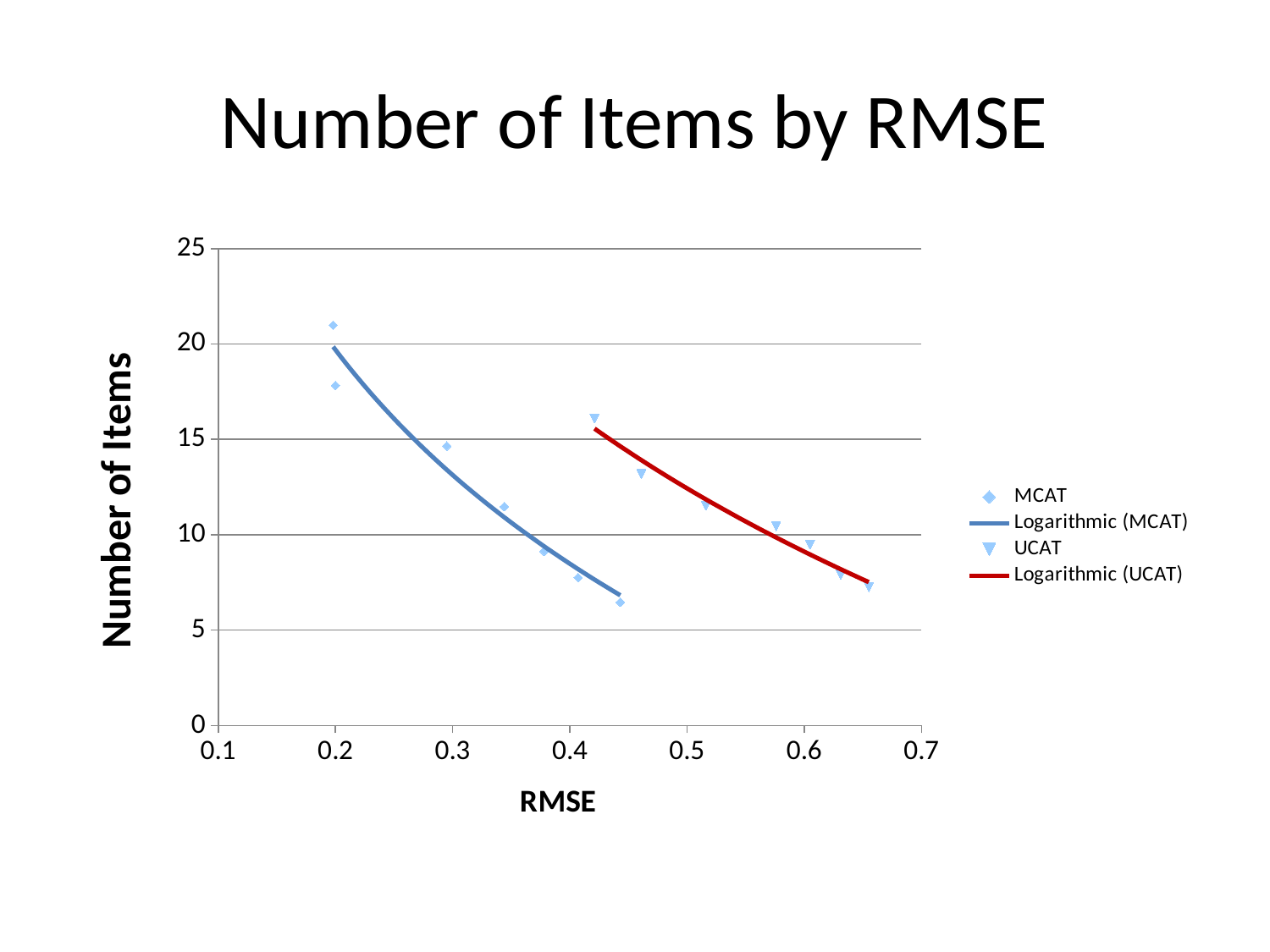
Which series has the larger RMSE values, MCAT or UCAT? UCAT Which series reaches a higher number of items, MCAT or UCAT? MCAT What kind of chart is shown on the slide? scatter chart How many UCAT data points are plotted? 7 Is the highest MCAT point greater or less than 20 items? greater As RMSE increases along the x axis, do the MCAT values rise or fall? fall How many entries does the chart's legend list? 4 Is the highest UCAT point greater or less than 15 items? greater Is the lowest MCAT point greater or less than 10 items? less As RMSE increases along the x axis, do the UCAT values rise or fall? fall What is the title of the chart? Number of Items by RMSE What is the label of the x axis? RMSE